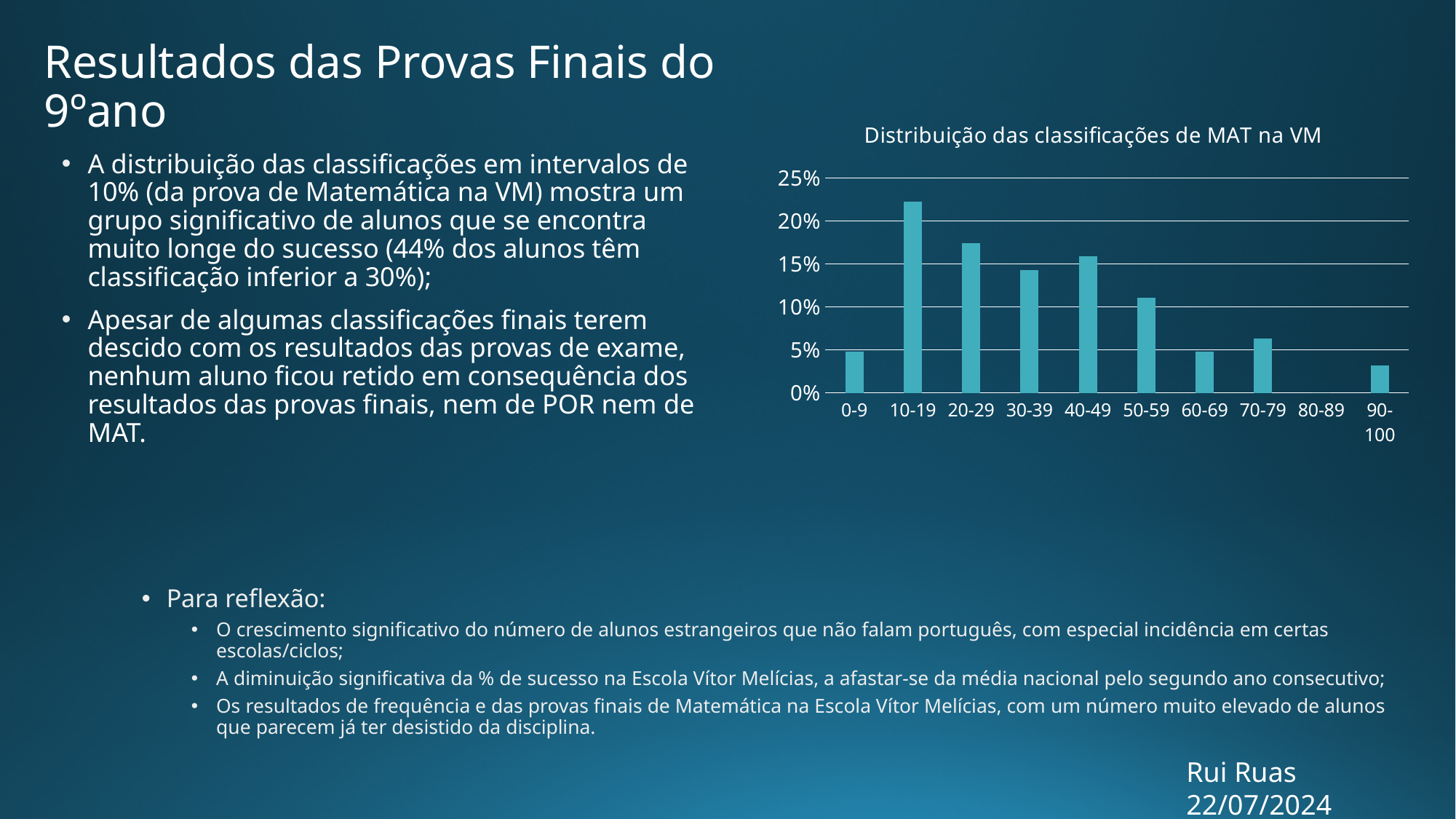
Which score interval has the highest percentage of students? 10-19 Which score interval has the lowest percentage of students? 80-89 How many score intervals (categories) are shown on the x axis of the chart? 10 Is the value for the 90-100 interval greater or less than 5%? less What kind of chart is shown on the slide? bar chart Is the value for the 30-39 interval greater or less than 15%? less What is the title of the chart? Distribuição das classificações de MAT na VM Which interval has a larger percentage, 50-59 or 70-79? 50-59 Is the value for the 10-19 interval greater or less than 20%? greater Going from the 10-19 interval to the 30-39 interval, do the bars rise or fall? fall Which interval has a larger percentage, 10-19 or 20-29? 10-19